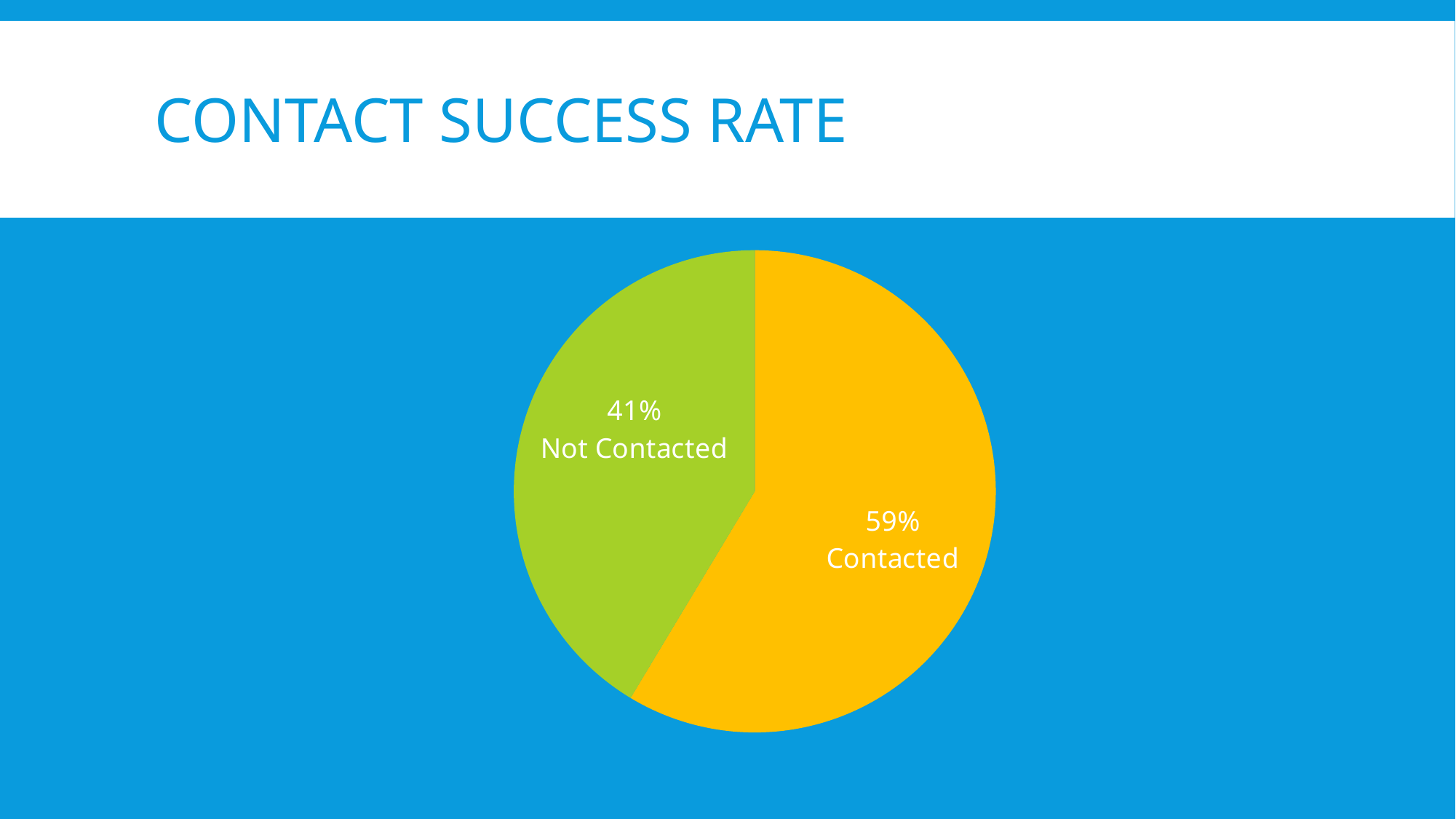
Which slice is the largest? Contacted What is the difference in percentage points between the Contacted and Not Contacted slices? 18 What share of the pie does the Not Contacted slice represent? 41% Which slice is the smallest? Not Contacted What percentage of the pie is labelled Not Contacted? 41% Which is larger, the Contacted slice or the Not Contacted slice? Contacted What kind of chart is shown on the slide? pie chart What percentage of the pie is labelled Contacted? 59% How many slices does the pie chart have? 2 What colour is the Contacted slice? yellow What is the title of the slide containing the pie chart? CONTACT SUCCESS RATE